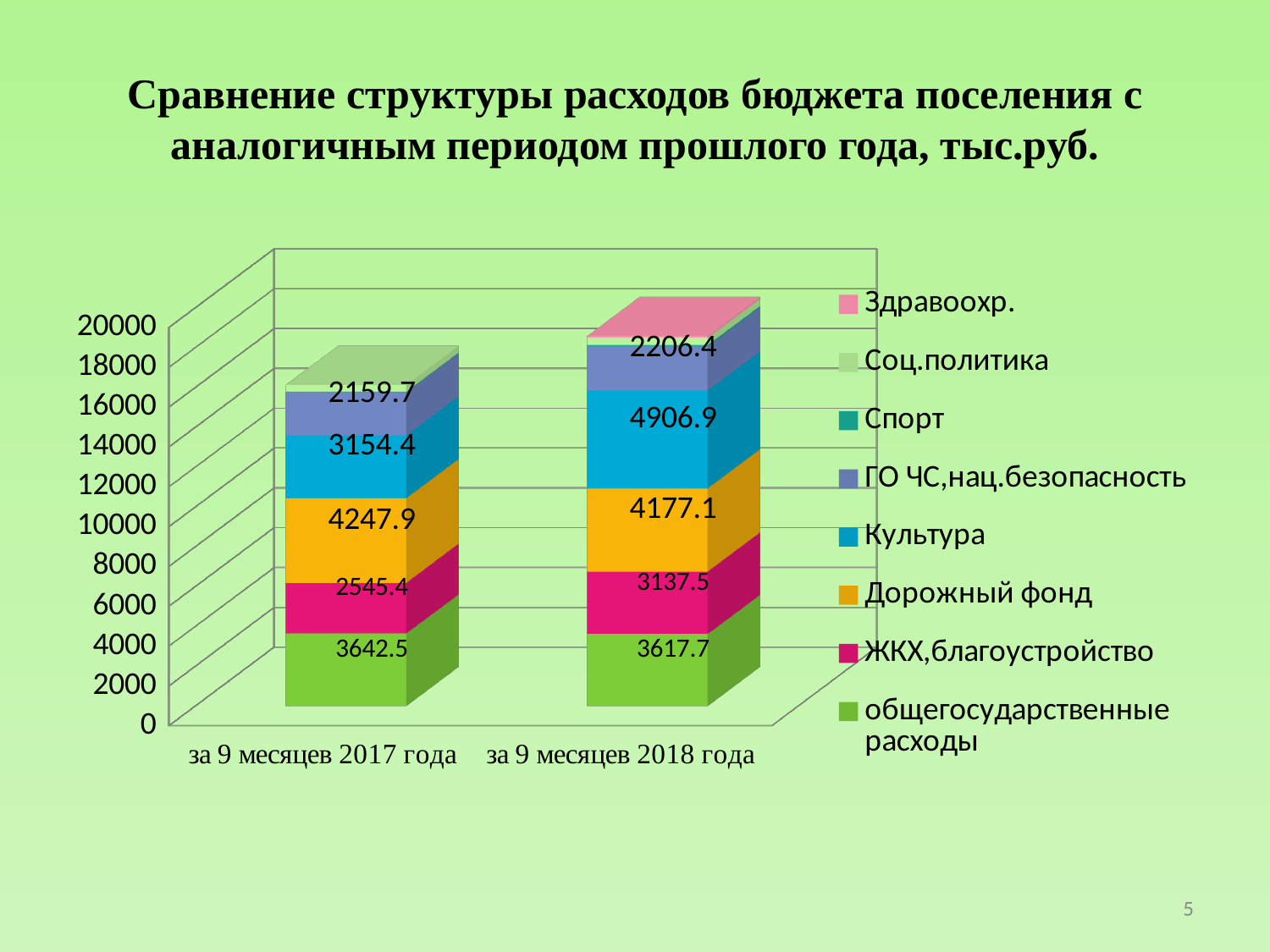
What is the value of ЖКХ,благоустройство for за 9 месяцев 2017 года? 2545.4 Which period has the larger value for Дорожный фонд, за 9 месяцев 2017 года or за 9 месяцев 2018 года? за 9 месяцев 2017 года How many periods (bars) are shown on the x axis? 2 How many series does the legend list? 8 What is the value of Дорожный фонд for за 9 месяцев 2017 года? 4247.9 What kind of chart is shown on the slide? stacked bar chart What is the value of ГО ЧС,нац.безопасность for за 9 месяцев 2018 года? 2206.4 What is the value of Культура for за 9 месяцев 2018 года? 4906.9 By how much did Культура increase from за 9 месяцев 2017 года to за 9 месяцев 2018 года? 1752.5 Is the total of the bar for за 9 месяцев 2017 года greater or less than 14000? greater What is the value of общегосударственные расходы for за 9 месяцев 2018 года? 3617.7 What is the difference between ЖКХ,благоустройство for 2018 and for 2017? 592.1